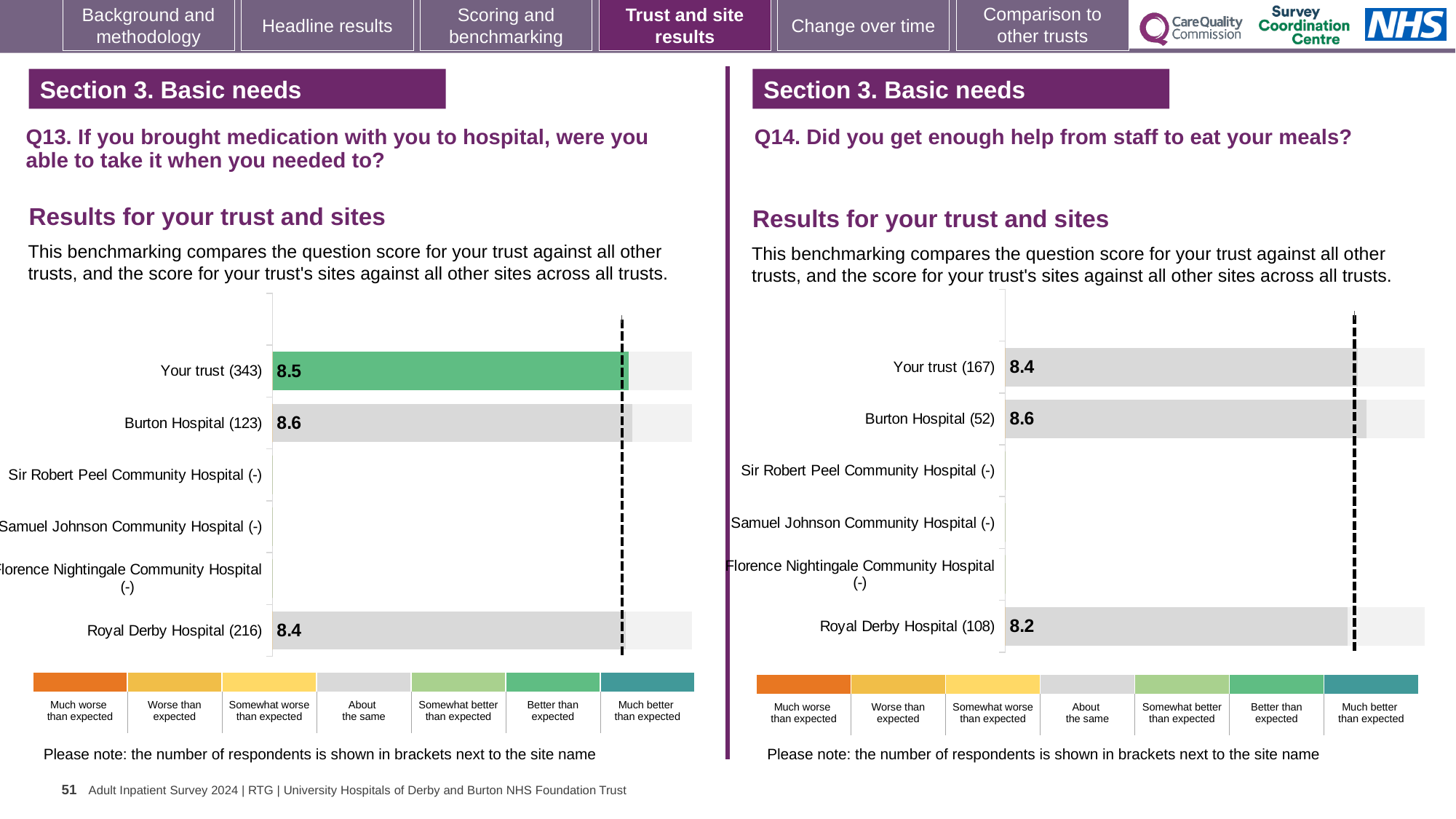
In the Q13 chart on the left, which bar is coloured green? Your trust (343) In the Q14 chart on the right, what is the score for Royal Derby Hospital (108)? 8.2 In the Q14 chart on the right, which site has the lowest score? Royal Derby Hospital (108) In the Q13 chart on the left, what is the score for Burton Hospital (123)? 8.6 In the Q13 chart on the left, what is the score for Your trust (343)? 8.5 In the Q14 chart on the right, what is the score for Your trust (167)? 8.4 In the Q13 chart on the left, which has the larger score, Burton Hospital (123) or Royal Derby Hospital (216)? Burton Hospital (123) What type of chart is used for the Q13 results on the left? Bar chart In the Q14 chart on the right, what is the difference between the scores for Burton Hospital (52) and Royal Derby Hospital (108)? 0.4 In the Q13 chart on the left, what is the score for Royal Derby Hospital (216)? 8.4 In the Q13 chart on the left, how many sites or trust rows are listed on the vertical axis? 6 In the Q14 chart on the right, which site has the highest score? Burton Hospital (52)